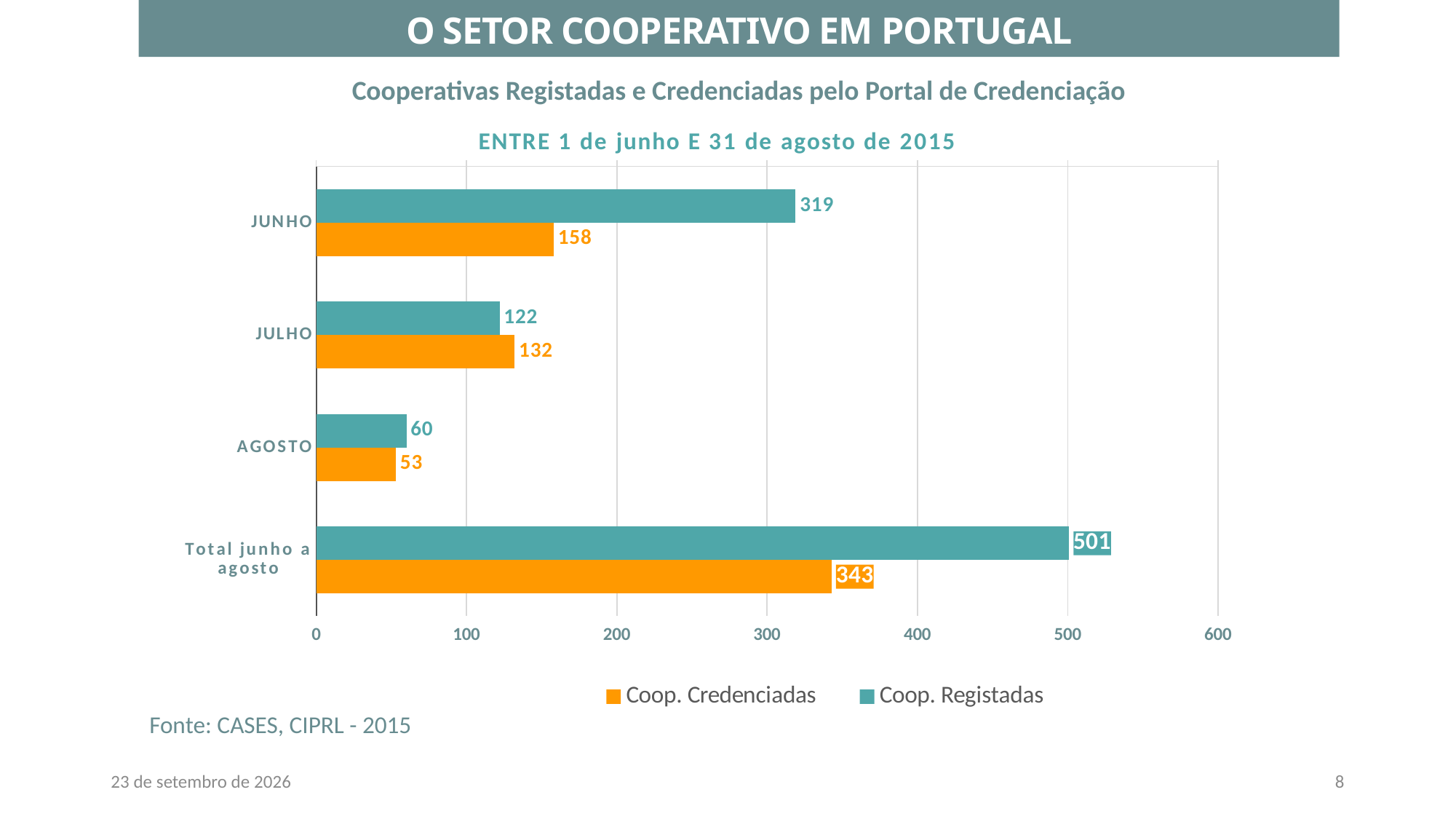
What is the value of Coop. Credenciadas for AGOSTO? 53 How many categories are shown on the y axis of the chart? 4 Among the three months (JUNHO, JULHO, AGOSTO), which has the highest value of Coop. Registadas? JUNHO Which colour represents Coop. Credenciadas in the chart? Orange What is the value of Coop. Registadas for Total junho a agosto? 501 What is the value of Coop. Registadas for JUNHO? 319 Among the three months (JUNHO, JULHO, AGOSTO), which has the lowest value of Coop. Credenciadas? AGOSTO How many series does the legend list? 2 What is the value of Coop. Credenciadas for JULHO? 132 Which is larger for JULHO: Coop. Registadas or Coop. Credenciadas? Coop. Credenciadas What kind of chart is shown on the slide? Bar chart What is the difference between Coop. Registadas and Coop. Credenciadas for JUNHO? 161